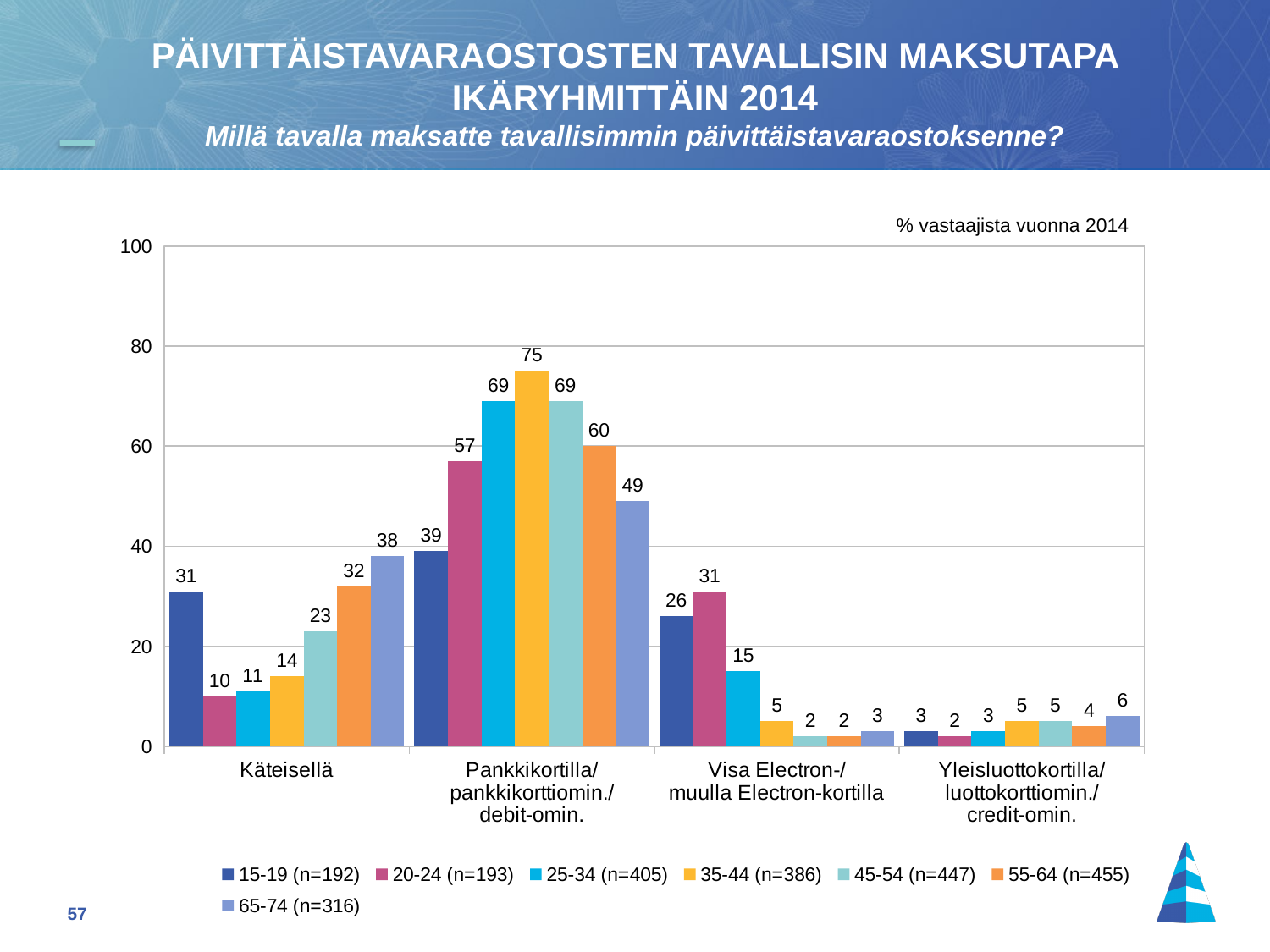
What is the value for the 20-24 age group in the Visa Electron-/muulla Electron-kortilla category? 31 What is the value for the 65-74 age group in the Yleisluottokortilla/luottokorttiomin./credit-omin. category? 6 Is the value for the 55-64 age group in the Pankkikortilla/pankkikorttiomin./debit-omin. category greater or less than 40? greater Which age group has the lowest value in the Käteisellä category? 20-24 (n=193) How many payment method categories are shown on the x axis? 4 What is the difference between the 35-44 and 65-74 values in the Pankkikortilla/pankkikorttiomin./debit-omin. category? 26 How many age-group series does the legend list? 7 What percentage of 15-19 year olds most commonly pay for groceries with cash (Käteisellä)? 31 In the Visa Electron-/muulla Electron-kortilla category, which is larger: the value for 15-19 or the value for 25-34? 15-19 What type of chart is shown on the slide? Bar chart What is the value for the 35-44 age group in the Pankkikortilla/pankkikorttiomin./debit-omin. category? 75 Which age group has the highest value in the Käteisellä category? 65-74 (n=316)